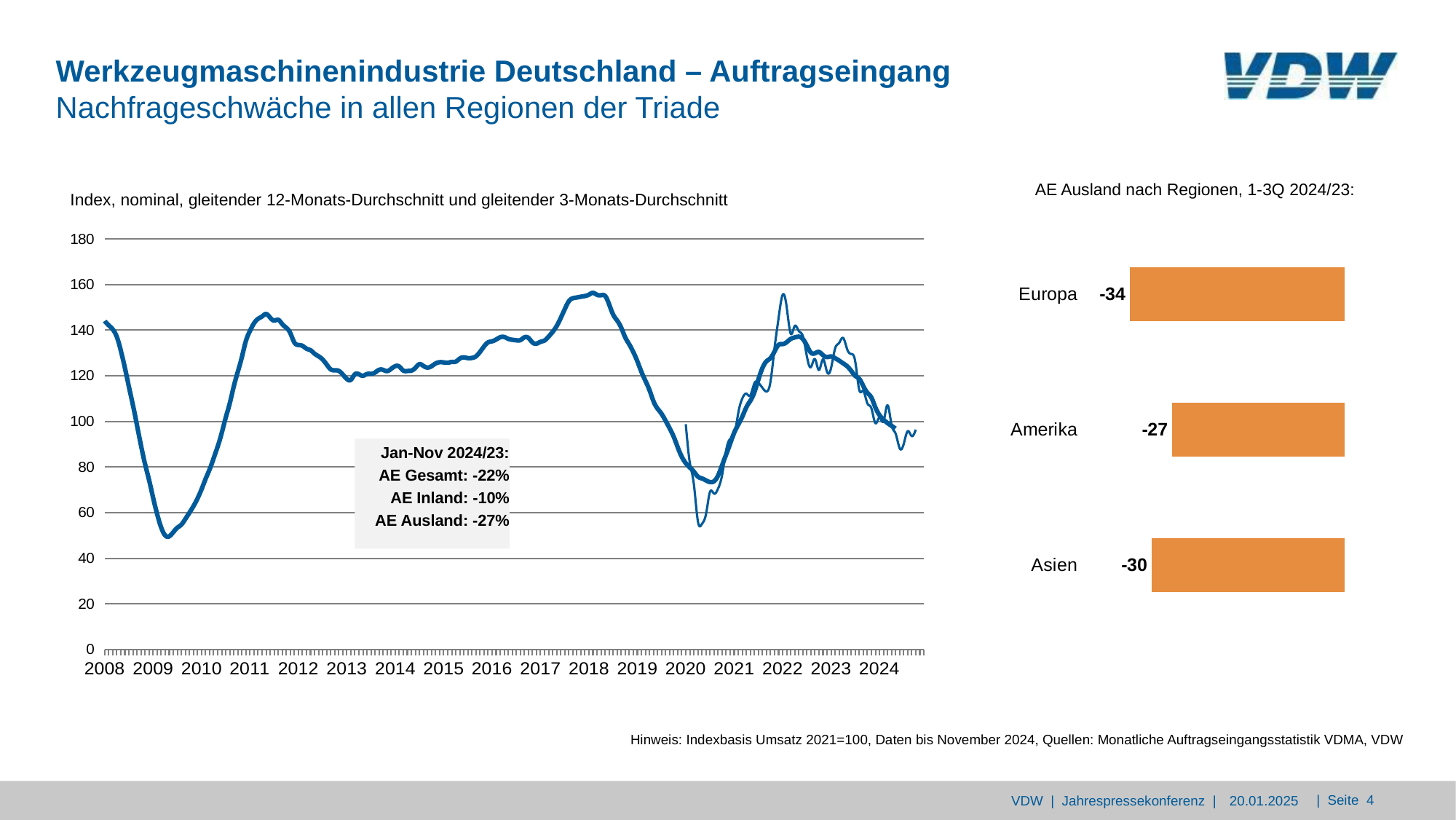
In the line chart on the left, is the peak value reached around 2018 greater or less than 140? greater What kind of chart is the chart on the right of the slide ('AE Ausland nach Regionen')? bar chart In the line chart on the left, is the lowest value reached in 2009 greater or less than 60? less In the bar chart 'AE Ausland nach Regionen, 1-3Q 2024/23', what is the difference between the values for Europa and Amerika? 7 In the bar chart 'AE Ausland nach Regionen, 1-3Q 2024/23', what is the value for Asien? -30 In the bar chart 'AE Ausland nach Regionen, 1-3Q 2024/23', which region has the highest value? Amerika What kind of chart is the chart on the left of the slide (Index, nominal)? line chart In the bar chart 'AE Ausland nach Regionen, 1-3Q 2024/23', what is the value for Europa? -34 In the bar chart 'AE Ausland nach Regionen, 1-3Q 2024/23', what is the value for Amerika? -27 In the bar chart 'AE Ausland nach Regionen, 1-3Q 2024/23', which region has the lowest value? Europa In the bar chart 'AE Ausland nach Regionen, 1-3Q 2024/23', how many regions are shown? 3 In the line chart on the left, do the values rise or fall between 2018 and 2020? fall